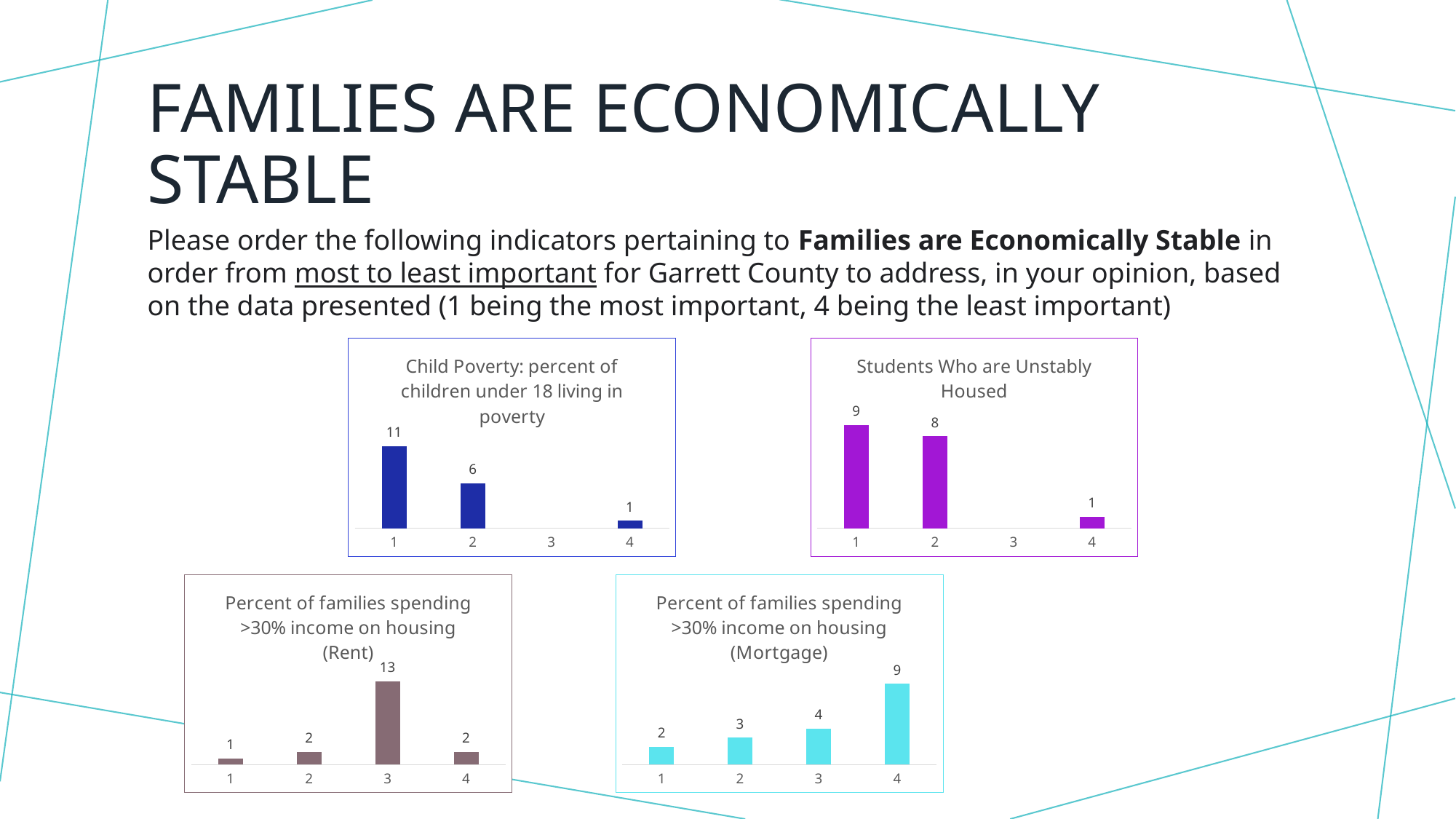
In the 'Percent of families spending >30% income on housing (Rent)' chart, what is the value for category 3? 13 How many charts are shown on the slide? 4 In the 'Students Who are Unstably Housed' chart, what is the difference between the values for category 1 and category 4? 8 In the 'Percent of families spending >30% income on housing (Mortgage)' chart, what is the value for category 4? 9 In the 'Child Poverty: percent of children under 18 living in poverty' chart, which is larger, the value for category 2 or category 4? 2 In the 'Percent of families spending >30% income on housing (Rent)' chart, which category has the highest value? 3 In the 'Percent of families spending >30% income on housing (Mortgage)' chart, do the values rise or fall from category 1 to category 4? rise What kind of chart is the 'Students Who are Unstably Housed' chart? bar chart In the 'Child Poverty: percent of children under 18 living in poverty' chart, what is the value for category 1? 11 In the 'Percent of families spending >30% income on housing (Mortgage)' chart, which category has the lowest value? 1 In the 'Child Poverty: percent of children under 18 living in poverty' chart, which category has the highest value? 1 In the 'Students Who are Unstably Housed' chart, what is the value for category 2? 8